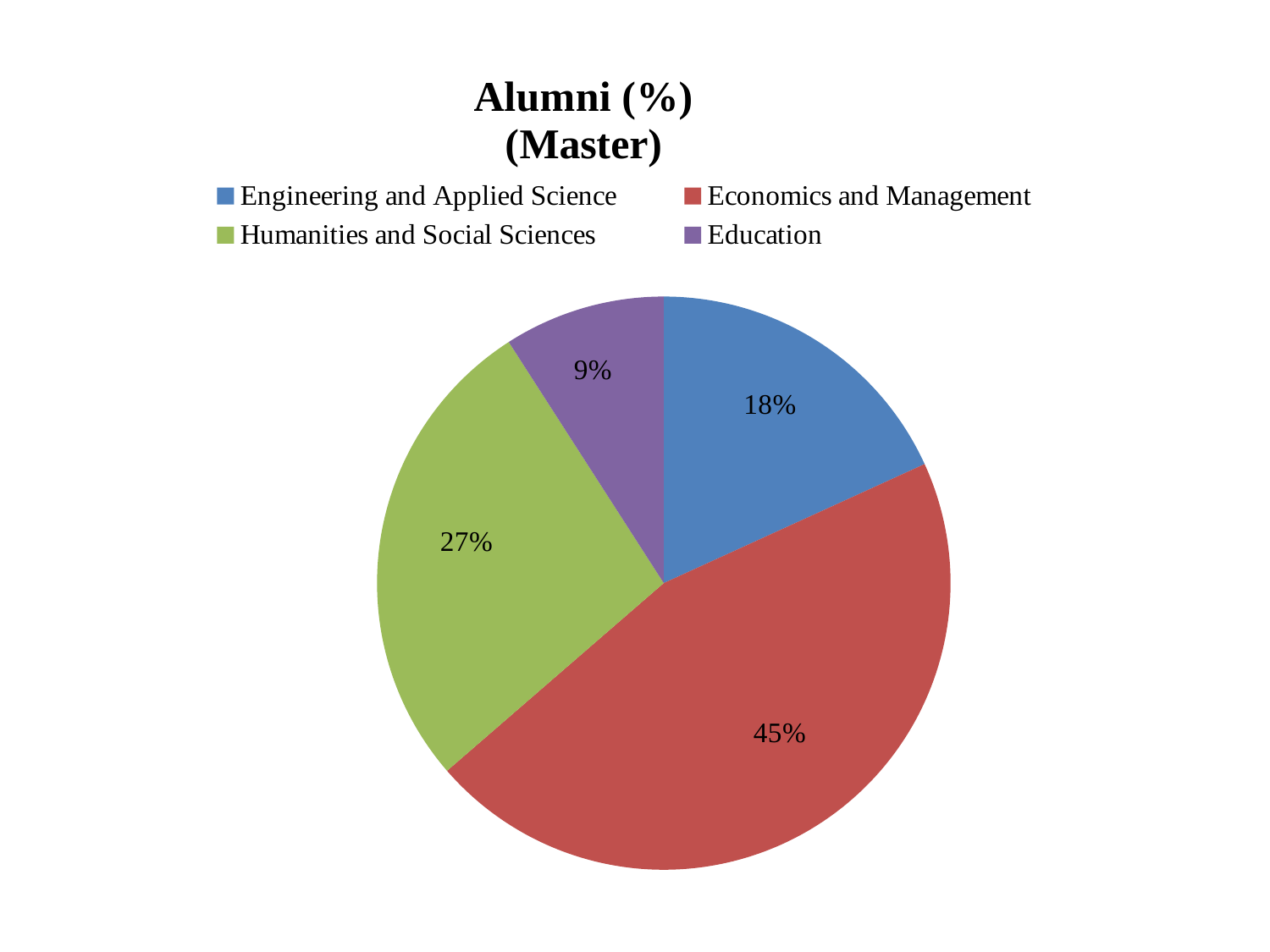
What colour is the Education slice? purple How many categories are shown in the pie chart? 4 What share of the pie does Economics and Management have? 45% Which is larger, Engineering and Applied Science or Humanities and Social Sciences? Humanities and Social Sciences What is the difference between the Economics and Management and Humanities and Social Sciences values? 18% What is the title of the chart? Alumni (%) (Master) What is the value for Humanities and Social Sciences? 27% What kind of chart is shown on the slide? pie chart Which category has the smallest slice? Education Which category has the largest slice? Economics and Management What is the value for Education? 9% What is the value for Engineering and Applied Science? 18%